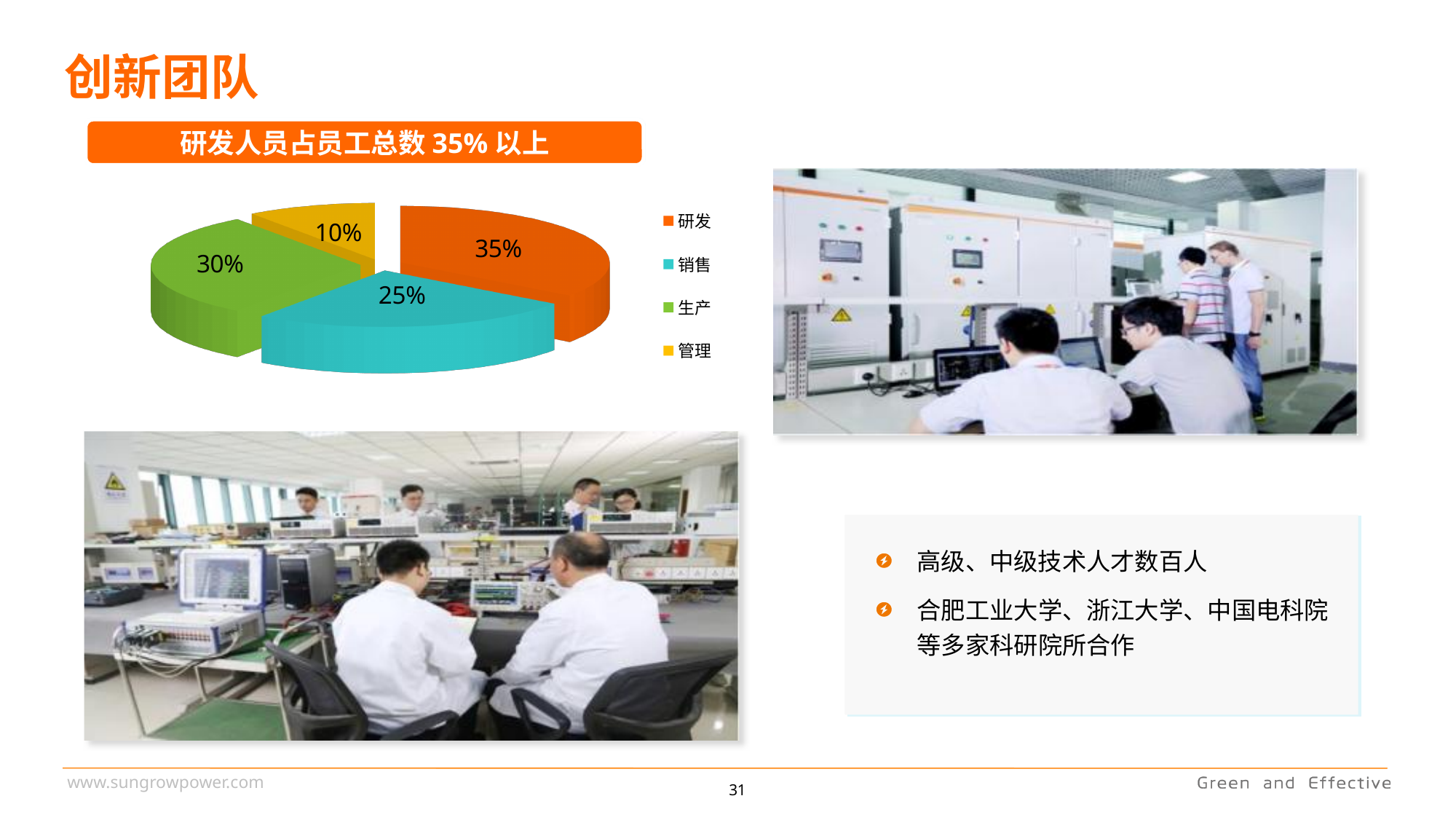
What share of the pie does 生产 represent? 30% How many categories does the pie chart show? 4 What is the difference between the shares of 研发 and 管理? 25% What share of the pie does 管理 represent? 10% What is the combined share of 研发 and 销售? 60% What share of the pie does 研发 represent? 35% What share of the pie does 销售 represent? 25% Which is larger, the share of 生产 or the share of 销售? 生产 Which category has the smallest slice of the pie? 管理 What colour is the 销售 slice in the pie chart? cyan What kind of chart is shown on the slide? pie chart Which category has the largest slice of the pie? 研发